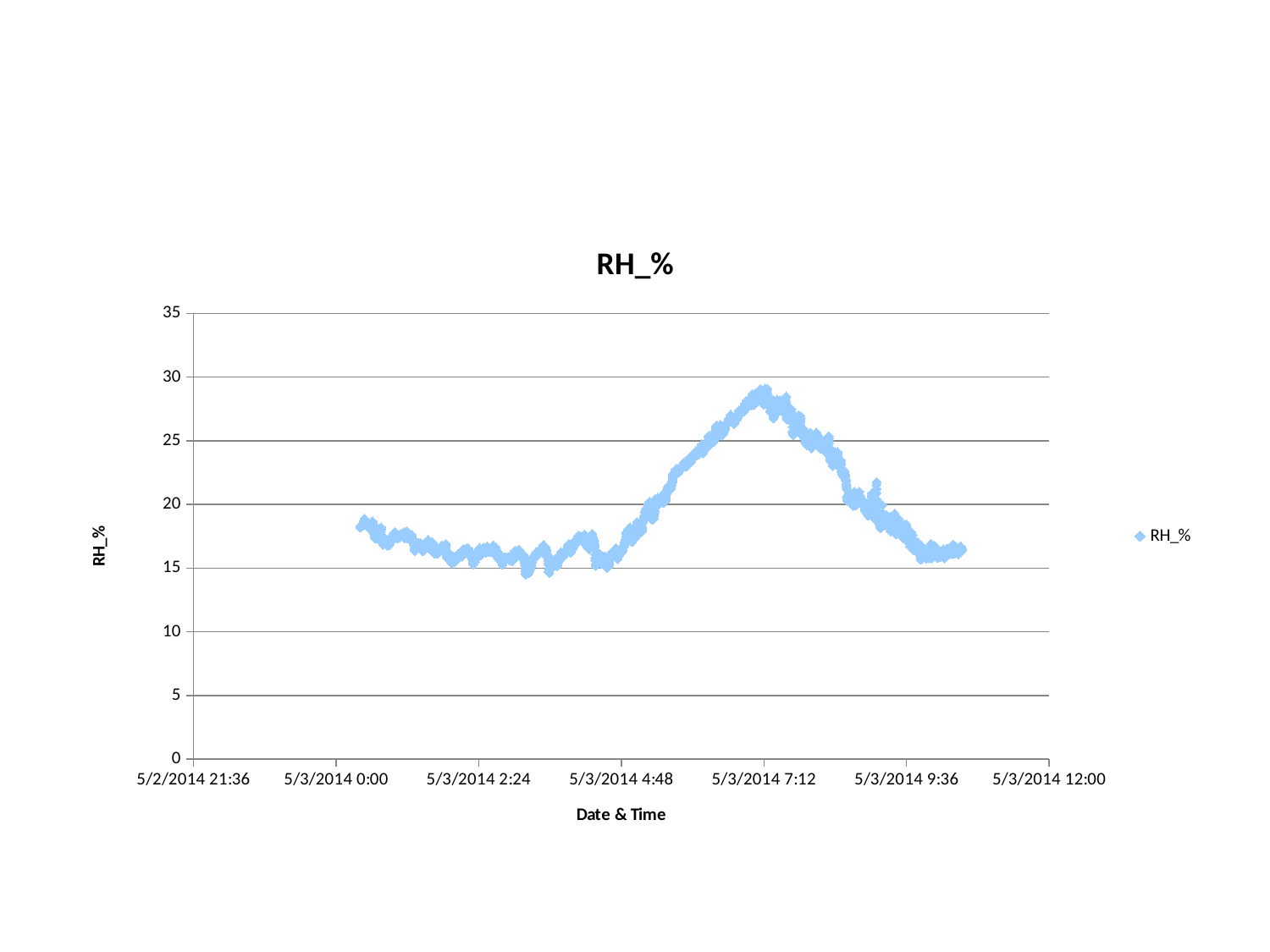
Is the highest RH_% value on the chart greater or less than 30? less Is the value for RH_% at 5/3/2014 2:24 greater or less than 20? less Do the RH_% values rise or fall between 5/3/2014 4:48 and 5/3/2014 7:12? rise Which is larger, the RH_% value at 5/3/2014 7:12 or at 5/3/2014 2:24? 5/3/2014 7:12 What is the title of the chart? RH_% What is the label of the x axis? Date & Time Is the value for RH_% at 5/3/2014 9:36 greater or less than 25? less What kind of chart is shown on the slide? scatter chart How many series does the legend list? 1 Do the RH_% values rise or fall between 5/3/2014 7:12 and 5/3/2014 9:36? fall